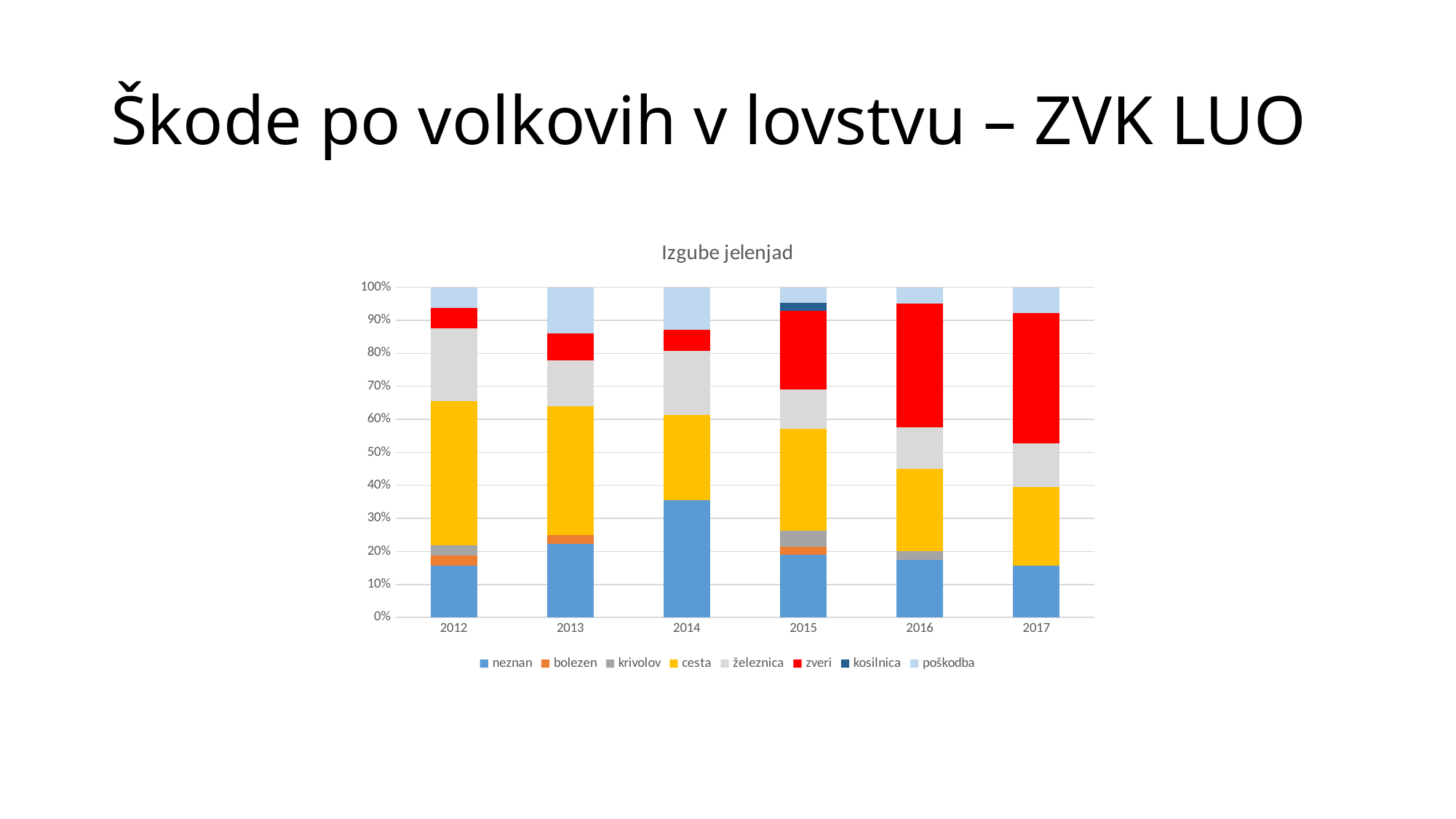
Which year has the largest share for neznan? 2014 Is the zveri share in 2012 greater or less than 10%? less In which year does the kosilnica series appear in the chart? 2015 Does the zveri share generally rise or fall from 2012 to 2017? rise Is the neznan share in 2014 greater or less than 30%? greater Which is larger, the zveri share in 2016 or in 2013? 2016 Is the neznan share in 2012 greater or less than 20%? less How many years are shown on the x axis of the chart? 6 What kind of chart is shown on the slide? Stacked bar chart How many series does the legend list? 8 What is the title of the chart? Izgube jelenjad